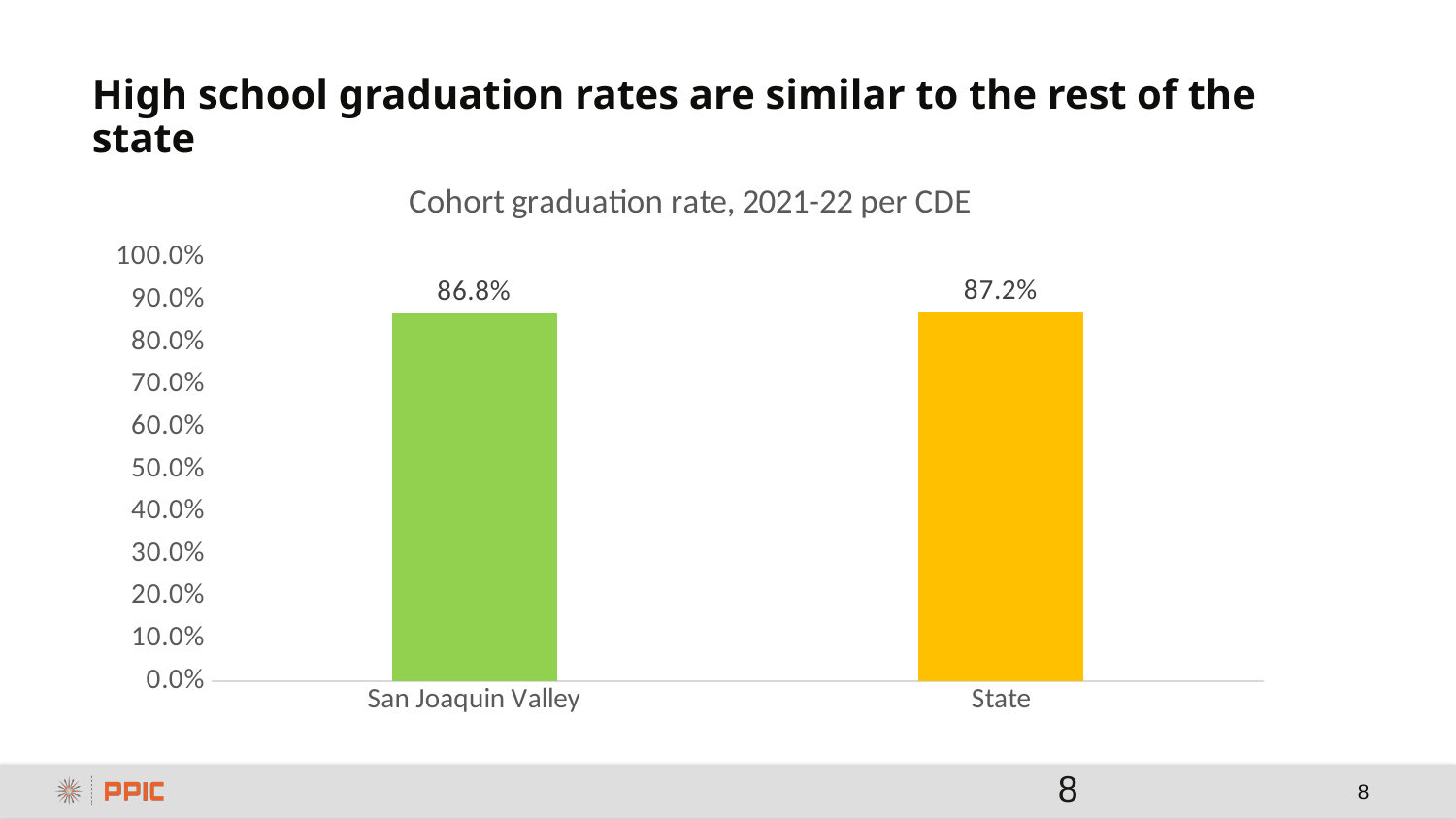
Which category has the lowest graduation rate? San Joaquin Valley What is the difference between the State graduation rate and the San Joaquin Valley graduation rate? 0.4 percentage points Which category has the highest graduation rate? State What is the title of the chart? Cohort graduation rate, 2021-22 per CDE Is the graduation rate for San Joaquin Valley greater or less than 80.0%? greater How many categories are shown on the chart? 2 What is the cohort graduation rate for the State? 87.2% What is the cohort graduation rate for San Joaquin Valley? 86.8% What kind of chart is shown on the slide? Bar chart Is the graduation rate for the State greater or less than 90.0%? less Which category has the higher graduation rate, San Joaquin Valley or State? State What colour is the bar for San Joaquin Valley? Green